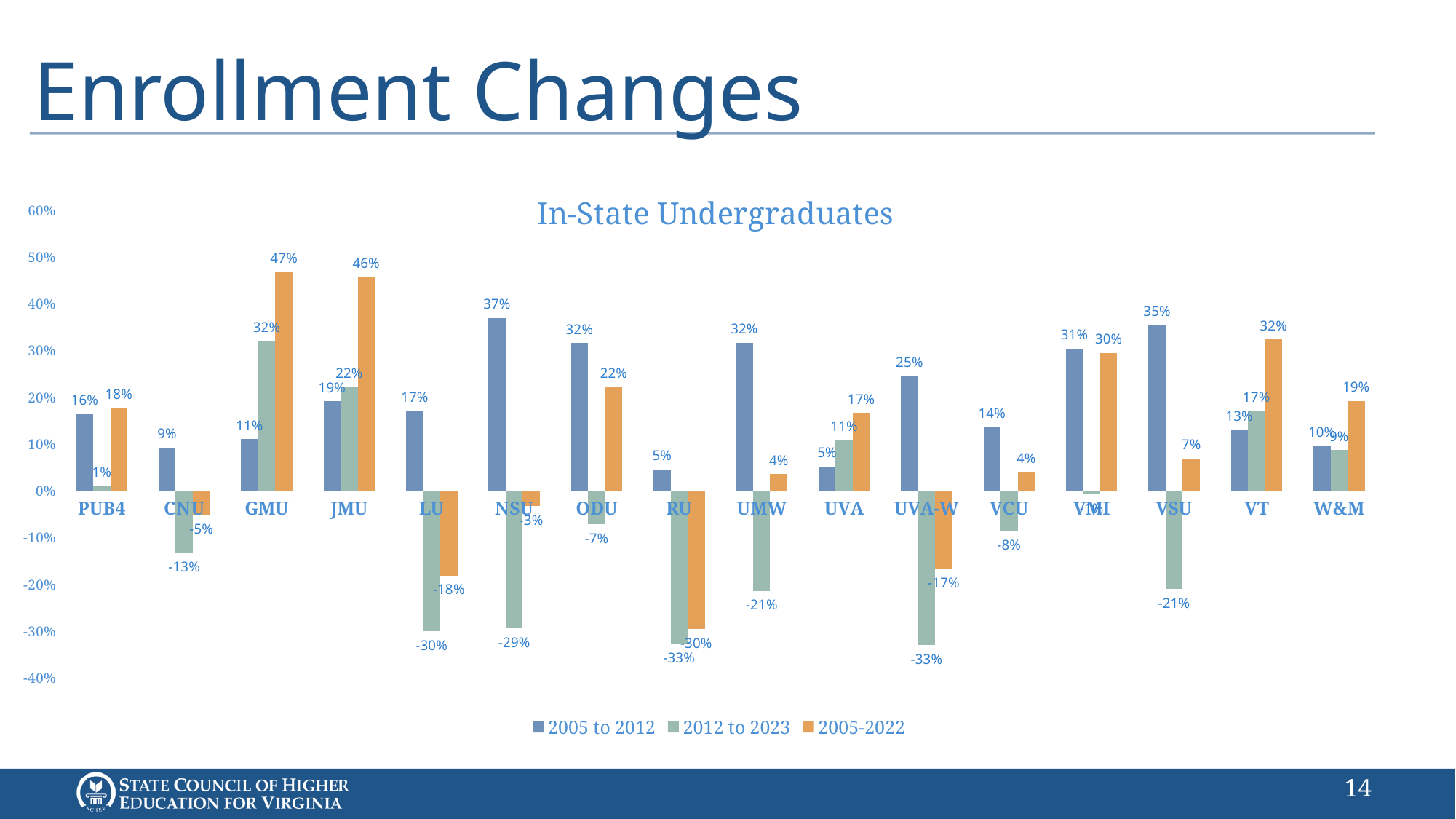
What is the difference between the 2005-2022 values for JMU and VT? 14% Is the 2005 to 2012 value for VSU greater or less than 30%? greater What is the 2012 to 2023 value for LU? -30% What is the title of the chart? In-State Undergraduates What is the 2005-2022 value for GMU? 47% How many series does the legend list? 3 What is the 2005 to 2012 value for UVA-W? 25% Which institution has the lowest 2005-2022 value? RU What type of chart is shown on the slide? bar chart Which is larger, the 2012 to 2023 value for GMU or the 2012 to 2023 value for JMU? GMU Which institution has the highest 2005 to 2012 value? NSU How many institutions (categories) are shown on the x axis? 16